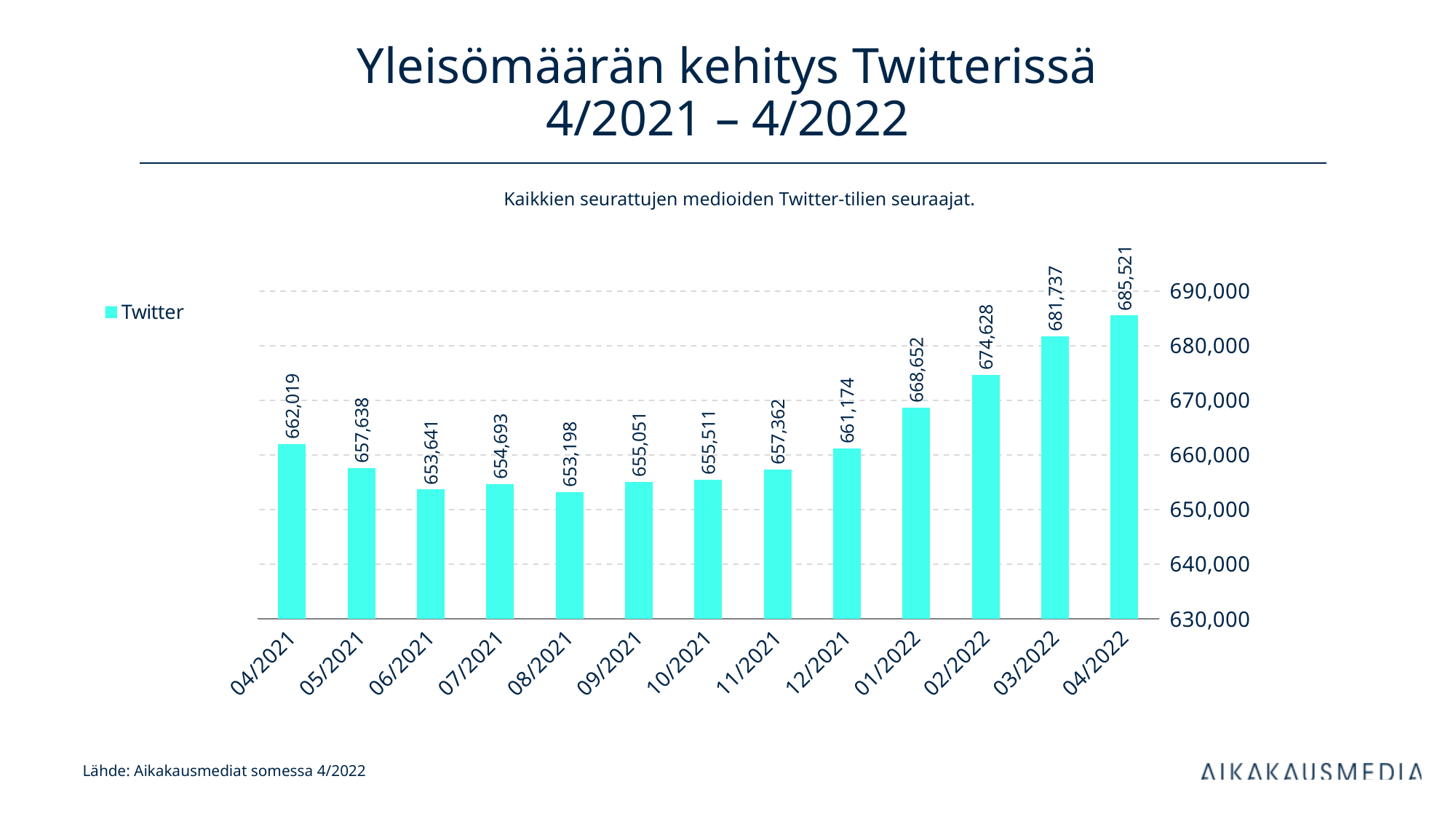
What is the value for 08/2021? 653,198 How many series does the legend list? 1 How many months are shown on the x axis? 13 Is the value for 02/2022 greater or less than 670,000? greater What is the value for 01/2022? 668,652 What is the difference between the values for 03/2022 and 02/2022? 7,109 What is the difference between the values for 04/2022 and 04/2021? 23,502 Which month has the lowest value? 08/2021 What is the value for 04/2021? 662,019 Which month has the highest value? 04/2022 Which is larger, the value for 12/2021 or the value for 05/2021? 12/2021 What kind of chart is shown on the slide? bar chart